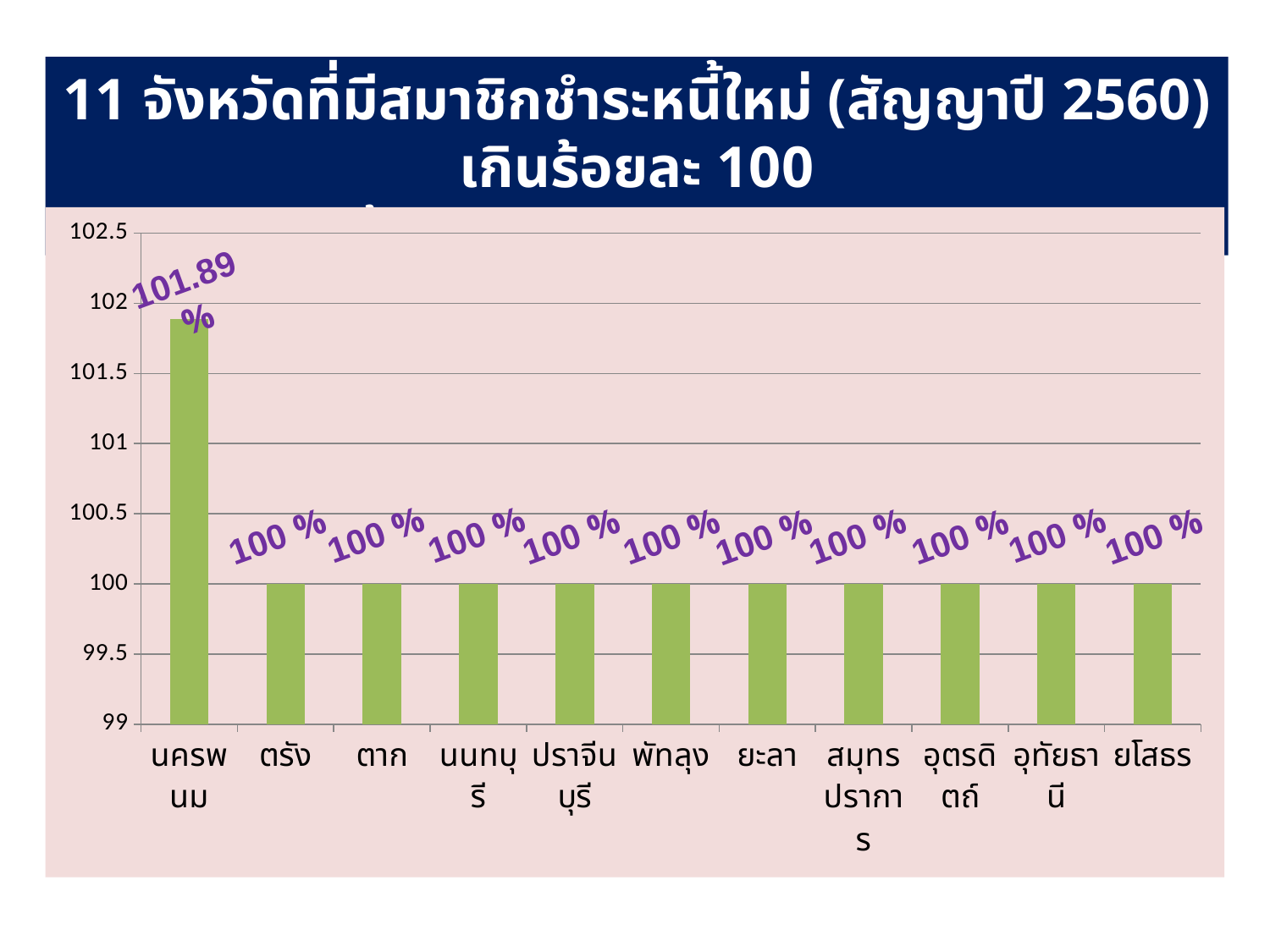
What is the value for นครพนม? 101.89 % Is the value for ยะลา greater or less than 100.5? less Is the value for นครพนม greater or less than 101.5? greater Which province has the highest value? นครพนม What is the value for ตรัง? 100 % What is the value for ยโสธร? 100 % How many provinces are shown on the chart? 11 What kind of chart is shown on the slide? bar chart What is the difference between the values for นครพนม and ตาก? 1.89 % What is the title of the chart? 11 จังหวัดที่มีสมาชิกชำระหนี้ใหม่ (สัญญาปี 2560) เกินร้อยละ 100 Which is larger, the value for นครพนม or the value for พัทลุง? นครพนม What is the value for สมุทรปราการ? 100 %